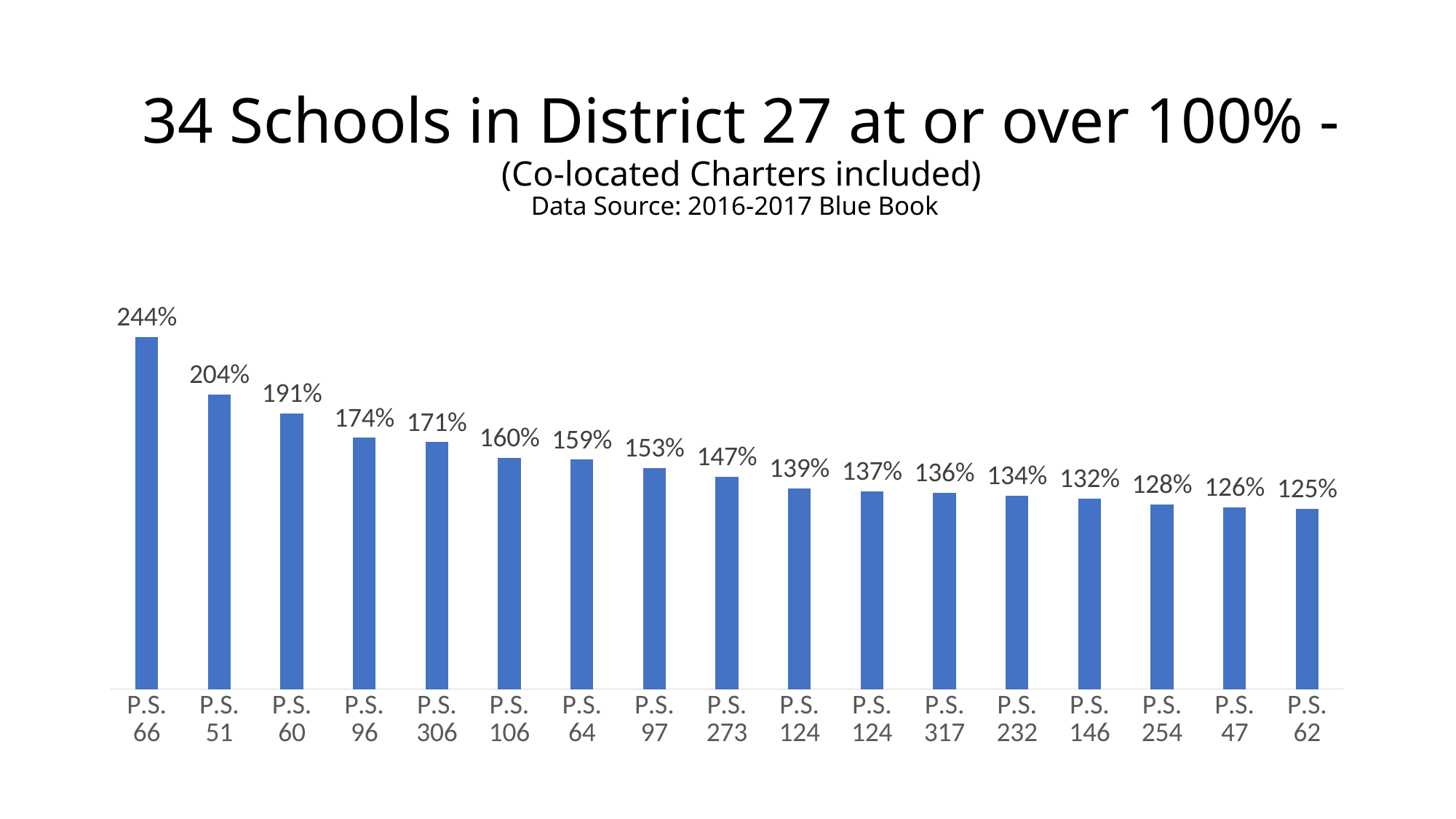
Which school has the highest value on the chart? P.S. 66 Which has a larger value, P.S. 60 or P.S. 106? P.S. 60 How many bars are plotted on the chart? 17 Which has a larger value, P.S. 232 or P.S. 97? P.S. 97 What is the difference between the values for P.S. 96 and P.S. 47? 48% What is the value shown for P.S. 66? 244% What is the value shown for P.S. 306? 171% What is the difference between the values for P.S. 66 and P.S. 51? 40% Which school has the lowest value on the chart? P.S. 62 What kind of chart is shown on the slide? Bar chart What is the value shown for P.S. 254? 128% Do the values rise or fall from left to right across the chart? Fall